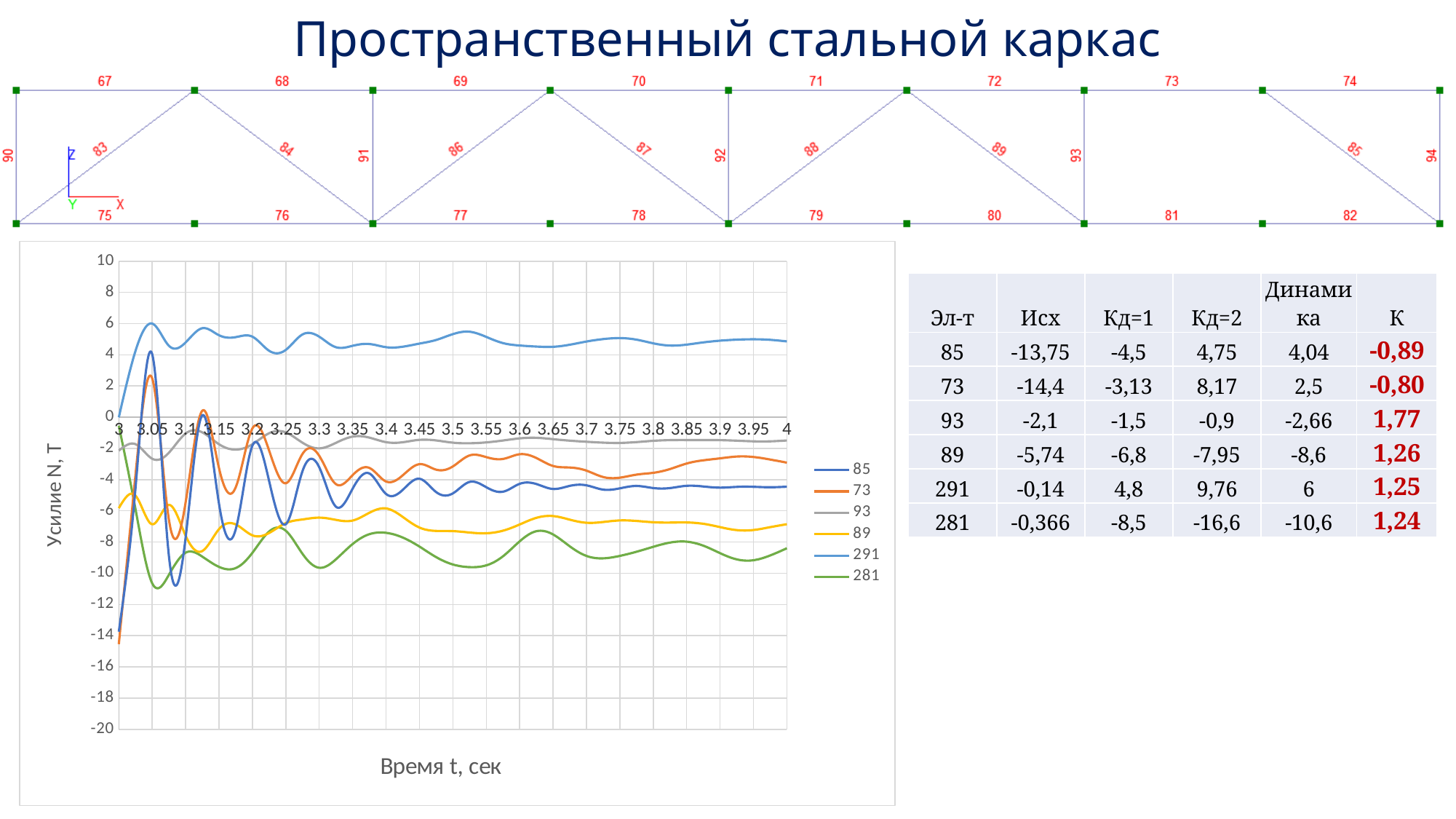
How many series does the chart legend list? 6 At t = 4, is the value of series 89 greater or less than -4? less At t = 4, is the value of series 281 greater or less than -6? less At t = 4, is the value of series 291 greater or less than 0? greater What is the title of the horizontal axis of the chart? Время t, сек Does series 291 rise or fall between t = 3 and t = 3.05? rise Which series has the lowest value at t = 4 on the chart? 281 At t = 4, which series has the larger value, 291 or 93? 291 Which series has the highest value at t = 4 on the chart? 291 What is the title of the vertical axis of the chart? Усилие N, Т What kind of chart is shown on the slide? line chart